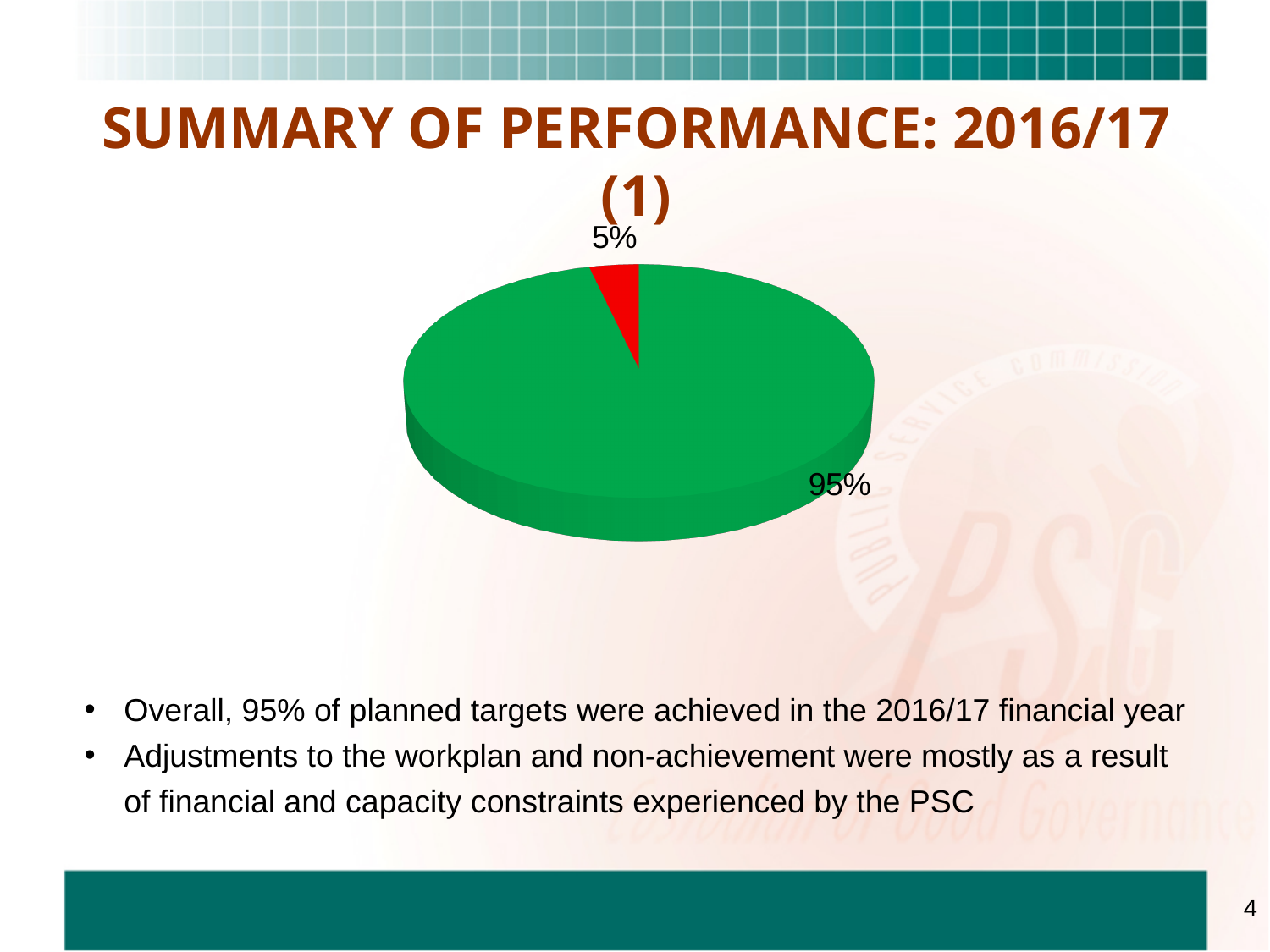
What kind of chart is shown on the slide? pie chart What share of the pie does the green slice represent? 95% Which is larger, the green slice or the red slice? the green slice How many slices does the pie chart have? 2 Which slice of the pie chart is the largest? the green slice (95%) What colour is the slice labelled 95%? green What share of the pie does the red slice represent? 5% Which slice of the pie chart is the smallest? the red slice (5%) What is the difference in percentage points between the green slice and the red slice? 90 What colour is the slice labelled 5%? red